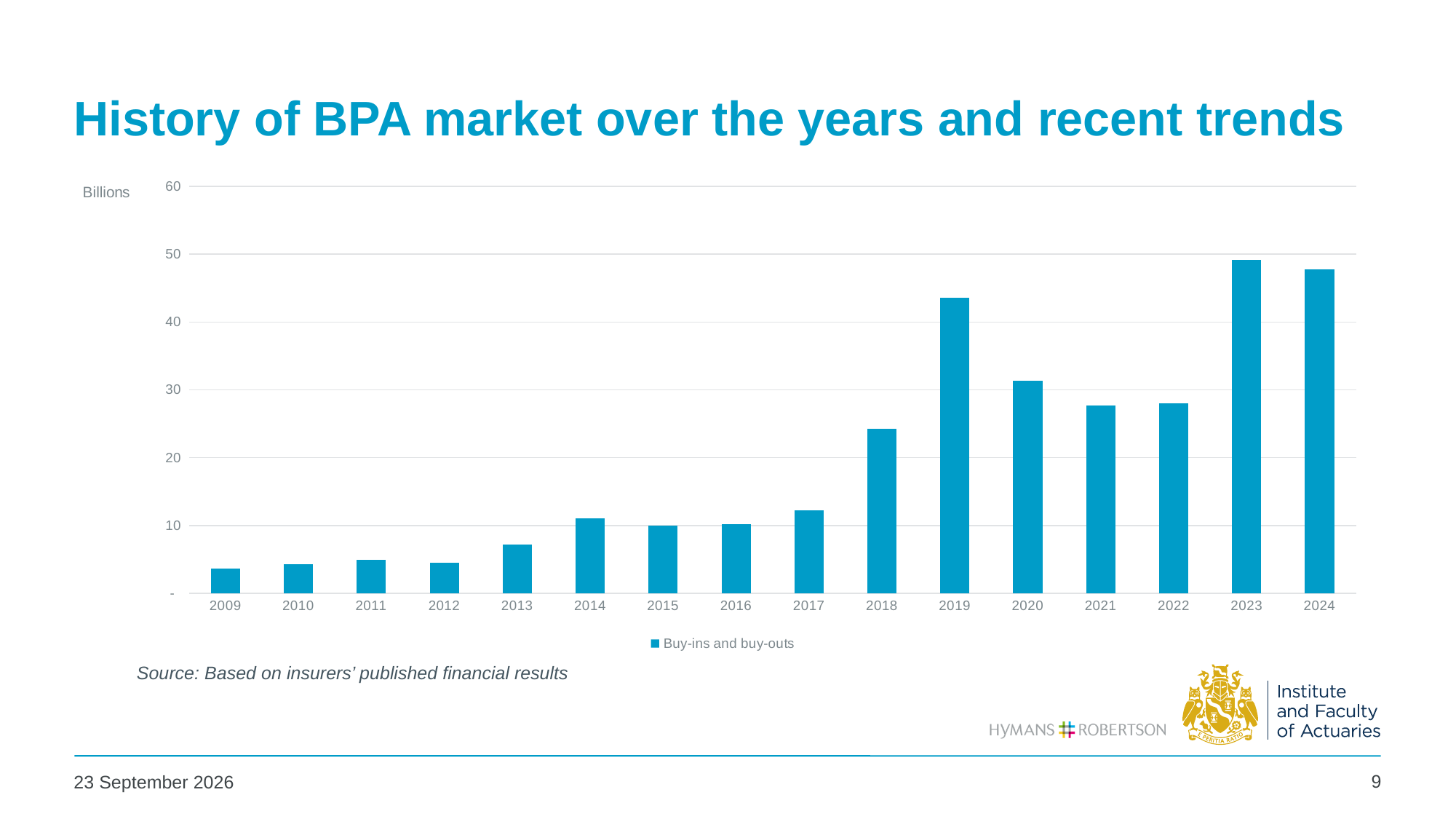
Overall, do the values rise or fall from 2009 to 2024? Rise Which year has the highest value in the chart? 2023 Is the value for 2013 greater or less than 10? less Is the value for 2021 greater or less than 30? less Is the value for 2018 greater or less than 20? greater What is the series name shown in the chart's legend? Buy-ins and buy-outs How many years are shown on the x axis of the chart? 16 What kind of chart is shown on the slide? Bar chart Which year has the lowest value in the chart? 2009 How many series does the chart's legend list? 1 Which year has the larger value, 2019 or 2020? 2019